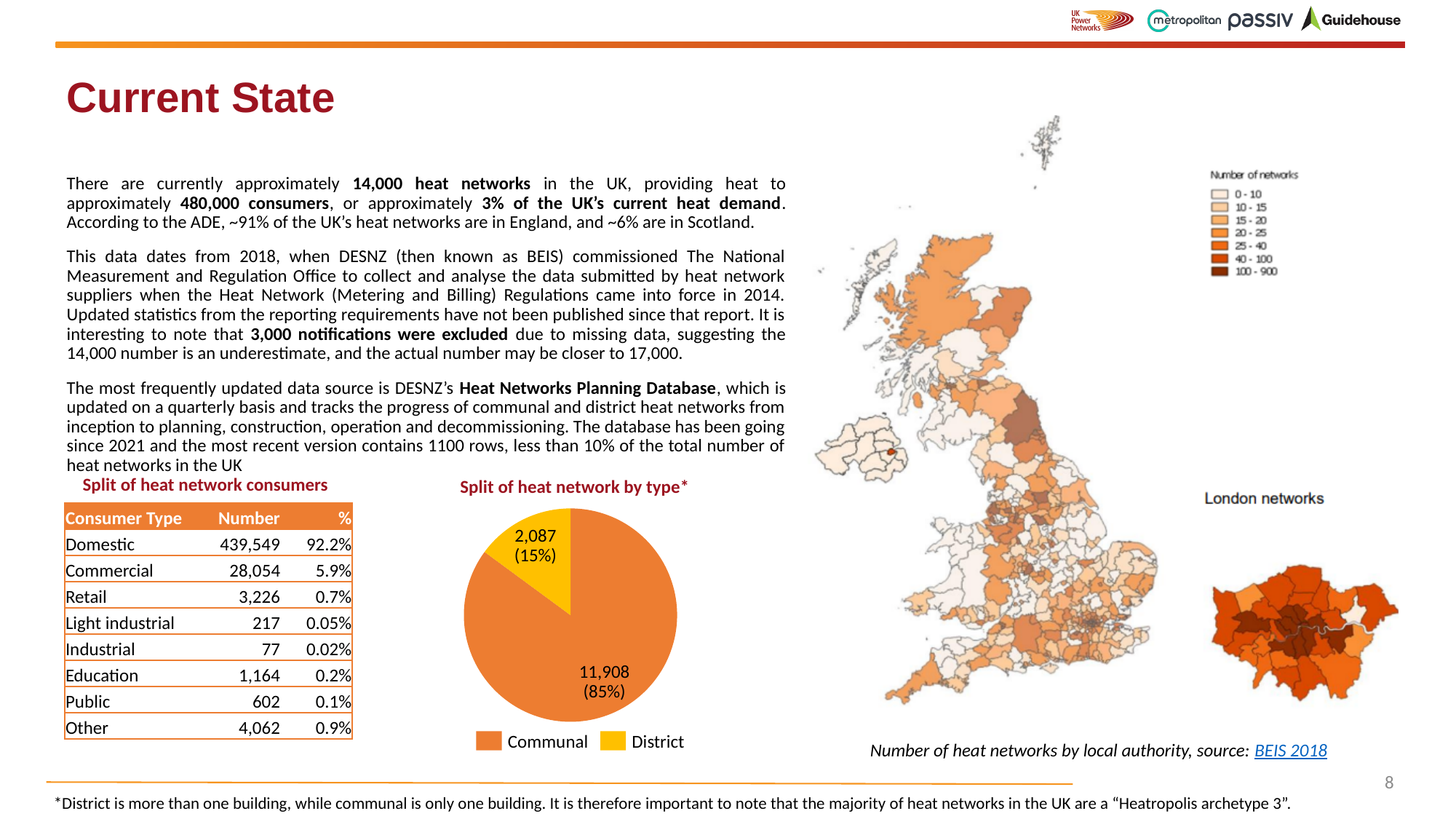
In the 'Split of heat network by type' chart, what colour is the District slice? Yellow In the 'Split of heat network by type' chart, what is the total of the two slices? 13,995 In the 'Split of heat network by type' chart, which category is the smallest? District In the 'Split of heat network by type' chart, what share of the pie does District represent? 15% In the 'Split of heat network by type' chart, what is the difference between the Communal and District values? 9,821 In the 'Split of heat network by type' chart, which is larger, Communal or District? Communal In the 'Split of heat network by type' chart, what share of the pie does Communal represent? 85% In the 'Split of heat network by type' chart, what is the value for Communal? 11,908 In the 'Split of heat network by type' chart, what is the value for District? 2,087 What kind of chart is 'Split of heat network by type'? Pie chart In the 'Split of heat network by type' chart, which category is the largest? Communal How many categories are shown in the 'Split of heat network by type' chart? 2